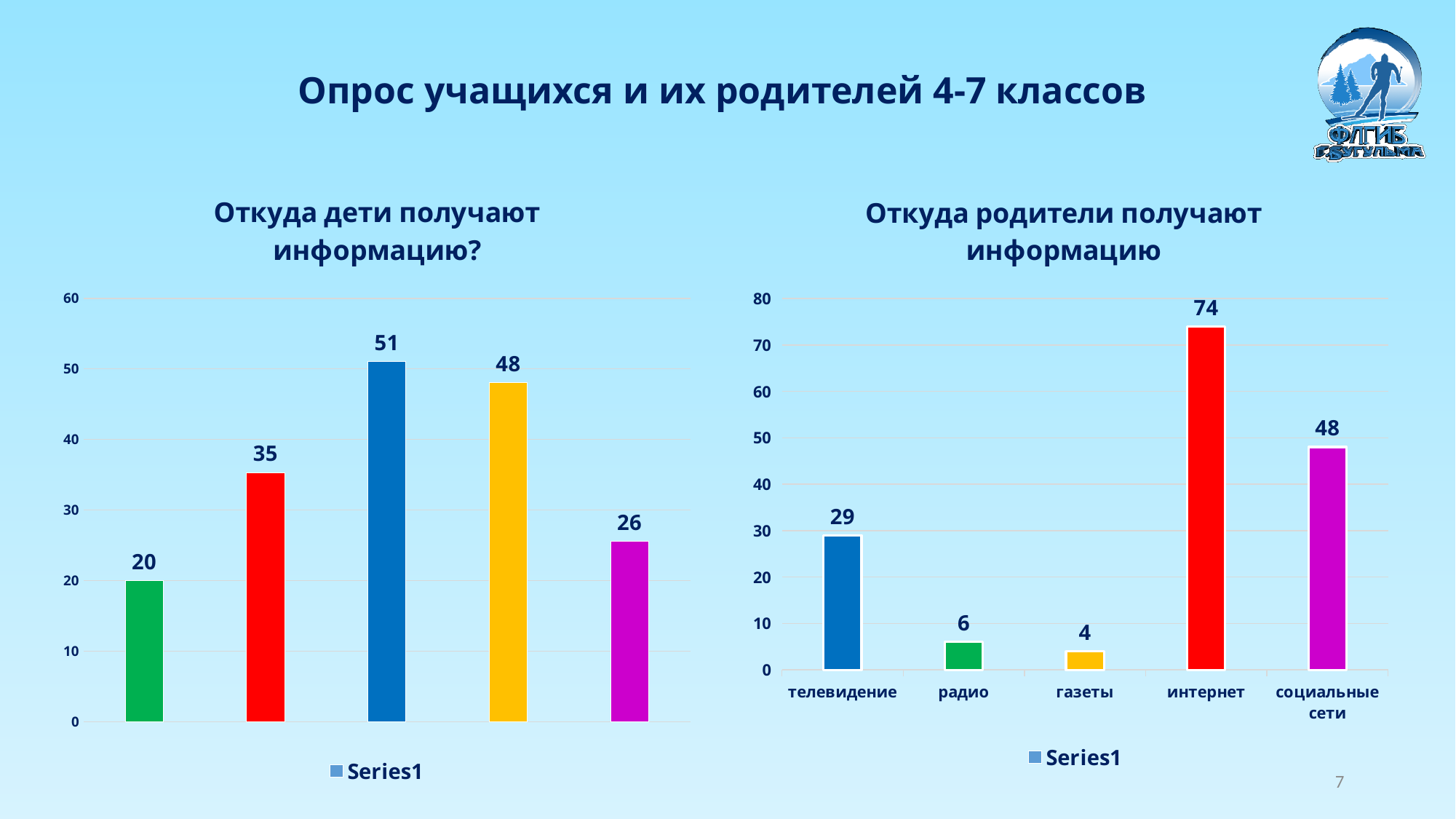
In the chart 'Откуда родители получают информацию', which is larger: радио or газеты? радио What type of chart is 'Откуда дети получают информацию?'? bar chart How many series does the legend of the chart 'Откуда родители получают информацию' list? 1 In the chart 'Откуда дети получают информацию?', what is the value of the tallest bar? 51 In the chart 'Откуда родители получают информацию', how many categories are shown on the x axis? 5 In the chart 'Откуда дети получают информацию?', what is the value of the first (green) bar? 20 In the chart 'Откуда дети получают информацию?', what is the difference between the third bar and the second bar? 16 In the chart 'Откуда родители получают информацию', what is the value for телевидение? 29 In the chart 'Откуда родители получают информацию', which category has the lowest value? газеты In the chart 'Откуда родители получают информацию', which category has the highest value? интернет In the chart 'Откуда родители получают информацию', what is the value for интернет? 74 In the chart 'Откуда родители получают информацию', what is the difference between the values for интернет and социальные сети? 26